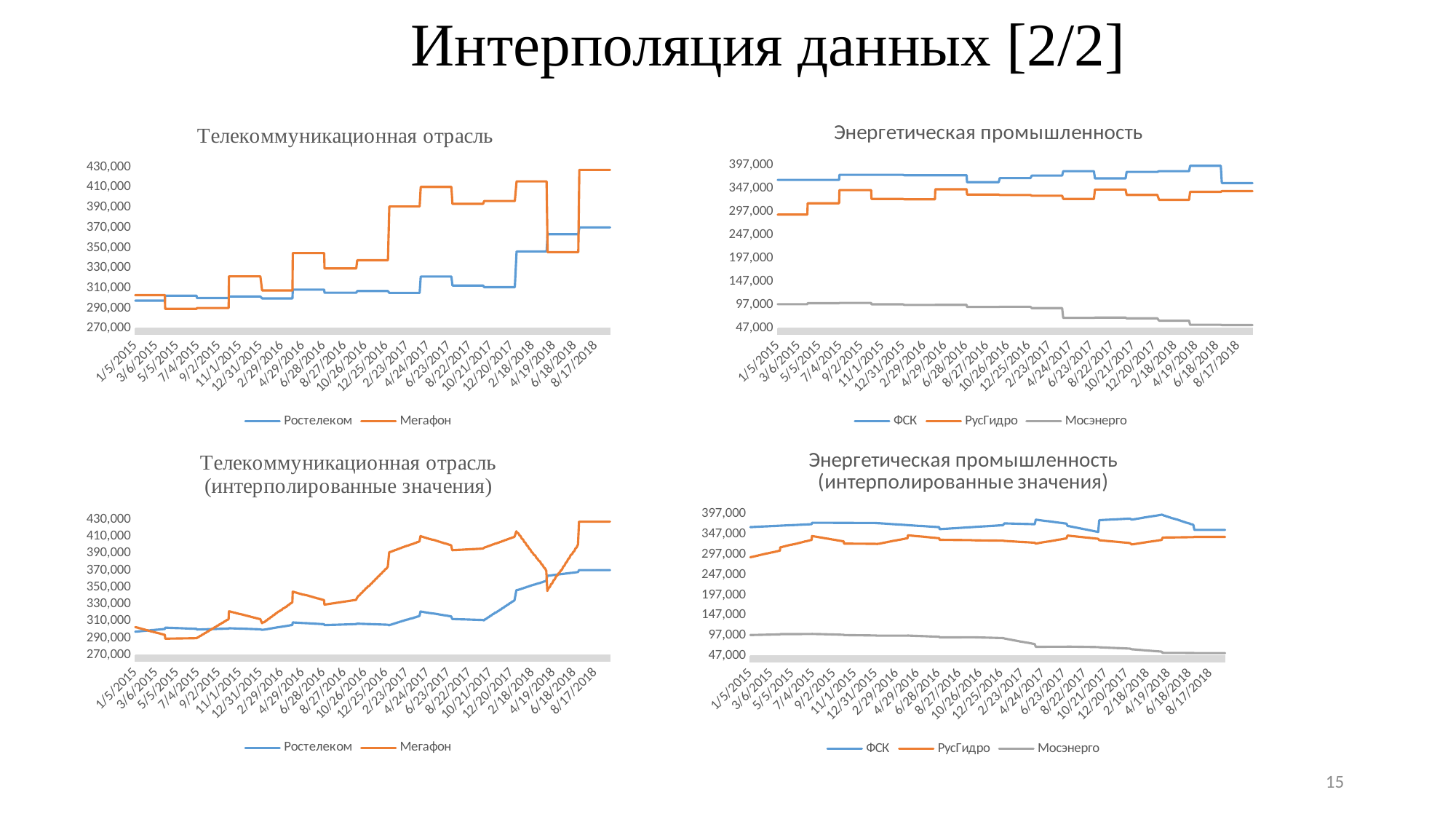
In the top-left chart "Телекоммуникационная отрасль", how many series does the legend list? 2 In the top-right chart "Энергетическая промышленность", which series has the lowest values across the whole period? Мосэнерго What kind of chart is the top-left chart titled "Телекоммуникационная отрасль"? Line chart In the top-left chart "Телекоммуникационная отрасль", is the value for Мегафон at 8/17/2018 greater or less than 410,000? greater In the bottom-left chart "Телекоммуникационная отрасль (интерполированные значения)", is the value for Ростелеком at 1/5/2015 greater or less than 310,000? less In the top-right chart "Энергетическая промышленность", how many series does the legend list? 3 In the bottom-left chart "Телекоммуникационная отрасль (интерполированные значения)", does the Ростелеком line overall rise or fall from 1/5/2015 to 8/17/2018? Rises What are the legend entries of the bottom-right chart "Энергетическая промышленность (интерполированные значения)"? ФСК, РусГидро, Мосэнерго In the top-right chart "Энергетическая промышленность", which series is higher at 8/17/2018, ФСК or Мосэнерго? ФСК In the bottom-right chart "Энергетическая промышленность (интерполированные значения)", does the Мосэнерго line rise or fall from 1/5/2015 to 8/17/2018? Falls In the bottom-left chart "Телекоммуникационная отрасль (интерполированные значения)", which series is higher at 8/17/2018, Мегафон or Ростелеком? Мегафон In the top-right chart "Энергетическая промышленность", is the value for Мосэнерго at 1/5/2015 greater or less than 147,000? less